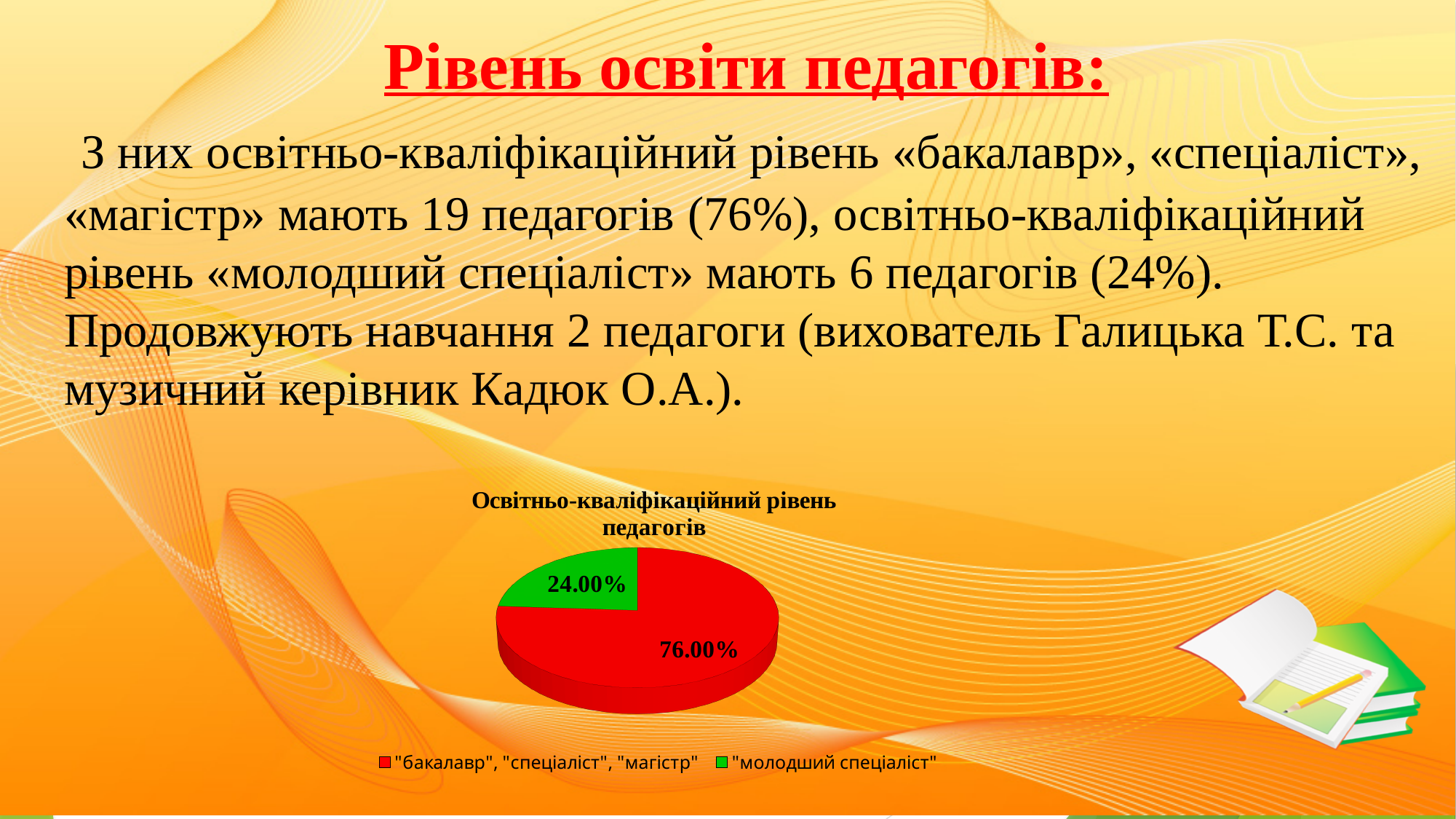
What is the difference in percentage points between the "бакалавр", "спеціаліст", "магістр" slice and the "молодший спеціаліст" slice? 52.00% What share of the pie does the "бакалавр", "спеціаліст", "магістр" slice have? 76.00% Which category has the smallest slice of the pie? "молодший спеціаліст" How many entries does the legend list? 2 Which category has the largest slice of the pie? "бакалавр", "спеціаліст", "магістр" What kind of chart is shown on the slide? pie chart What share of the pie does the "молодший спеціаліст" slice have? 24.00% Which slice is larger: "молодший спеціаліст" or "бакалавр", "спеціаліст", "магістр"? "бакалавр", "спеціаліст", "магістр" How many categories does the pie chart show? 2 What colour is the "молодший спеціаліст" slice? green What is the title of the chart? Освітньо-кваліфікаційний рівень педагогів